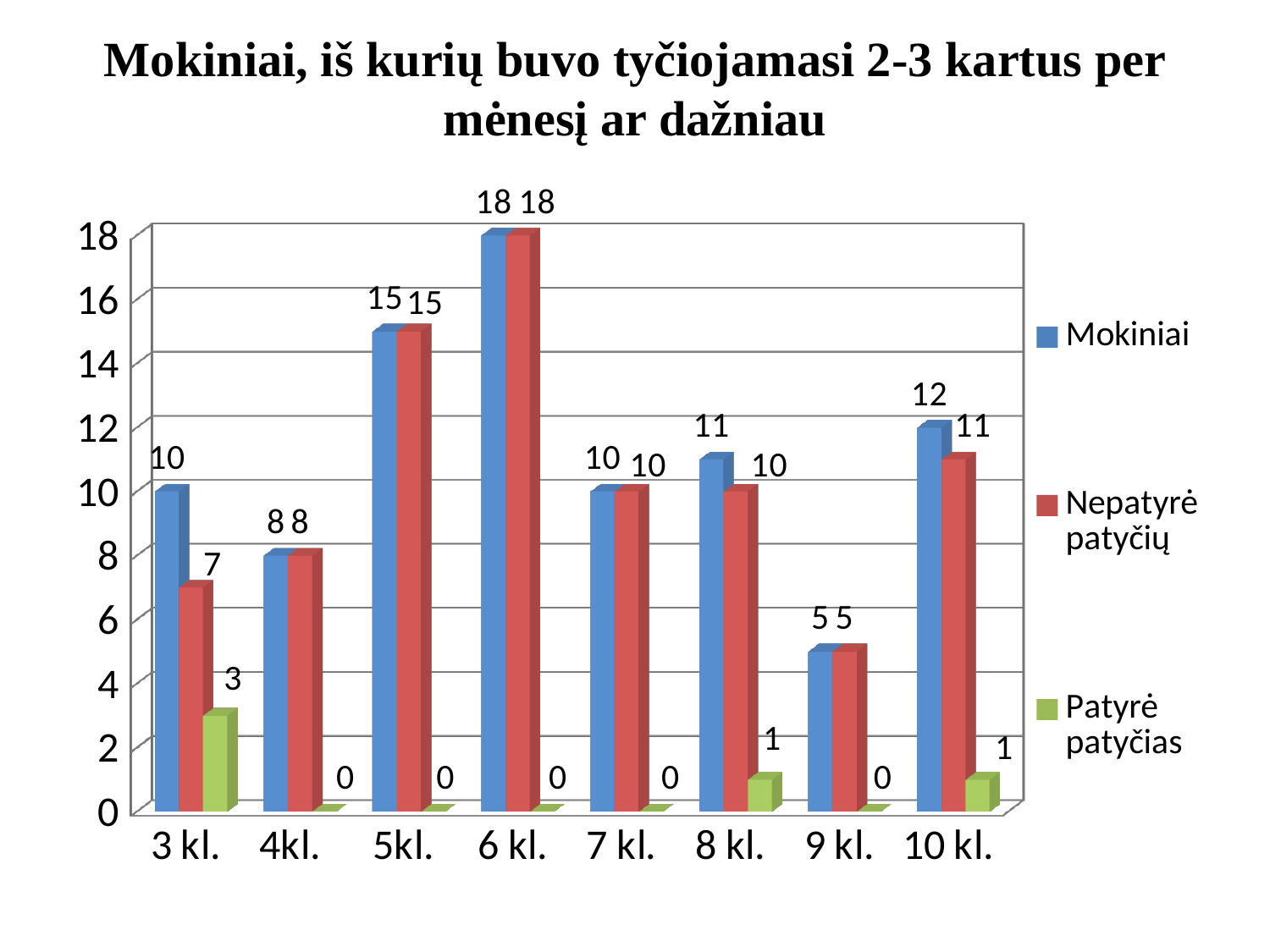
What is the value for Nepatyrė patyčių in 3 kl.? 7 What kind of chart is shown on the slide? bar chart Which is larger in 8 kl., Mokiniai or Nepatyrė patyčių? Mokiniai What is the value for Patyrė patyčias in 8 kl.? 1 How many series does the legend list? 3 How many classes are shown on the x axis? 8 What is the value for Mokiniai in 10 kl.? 12 Which class has the lowest value for Mokiniai? 9 kl. Which class has the highest value for Mokiniai? 6 kl. What is the value for Mokiniai in 6 kl.? 18 What is the value for Patyrė patyčias in 3 kl.? 3 What is the difference between Mokiniai and Nepatyrė patyčių in 3 kl.? 3